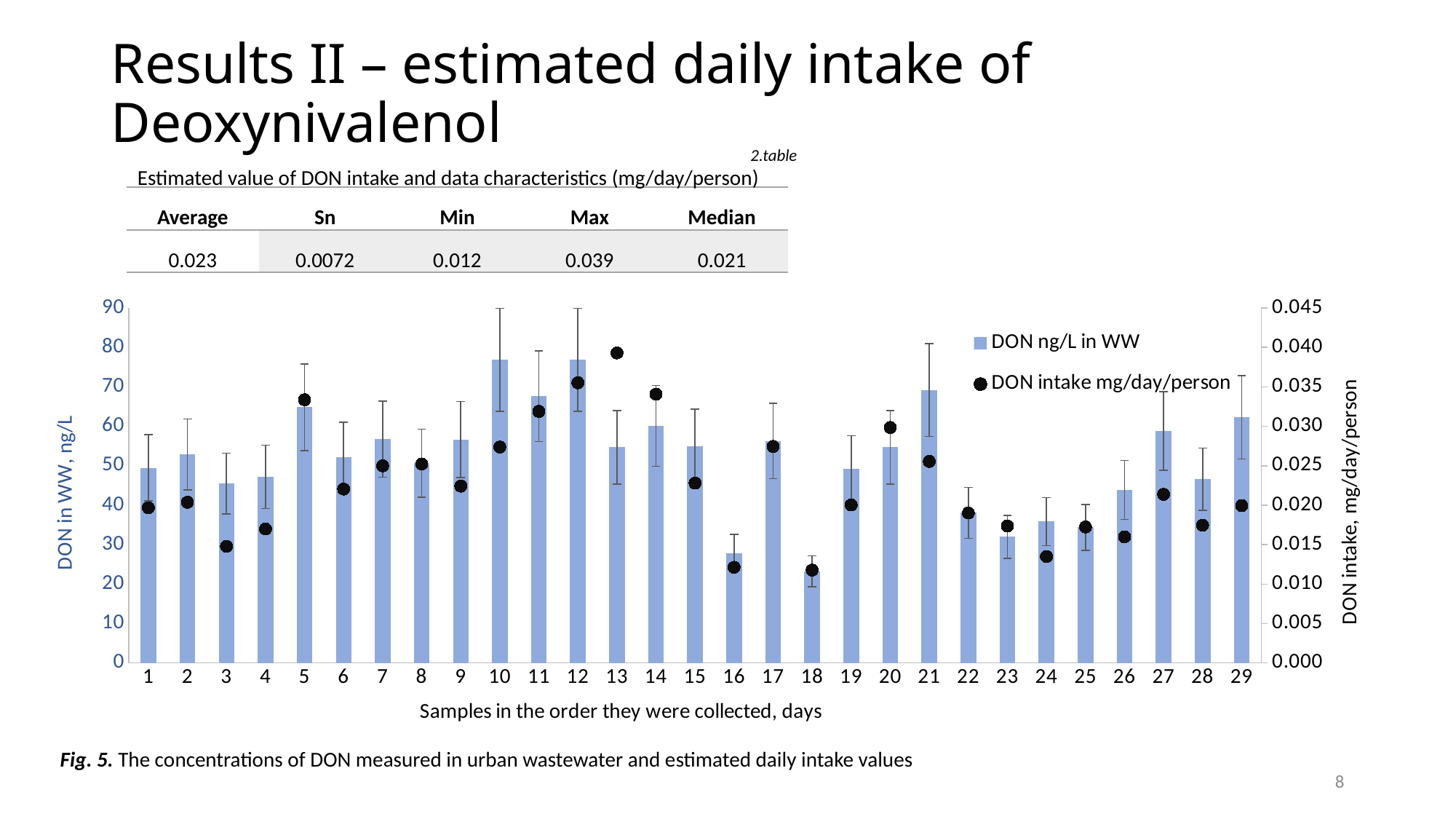
Which has the larger DON ng/L in WW bar, sample 10 or sample 1? sample 10 Which sample has the lowest DON ng/L in WW bar? 18 Is the DON intake mg/day/person value for sample 13 greater or less than 0.035? greater How many samples are plotted along the x axis of the chart? 29 Which sample has the highest DON intake mg/day/person point? 13 How many series does the chart legend list? 2 What kind of chart is used to show DON ng/L in WW? bar chart What is the label of the x axis of the chart? Samples in the order they were collected, days Is the DON ng/L in WW value for sample 18 greater or less than 30? less Which has the larger DON ng/L in WW bar, sample 29 or sample 28? sample 29 Is the DON ng/L in WW value for sample 21 greater or less than 60? greater